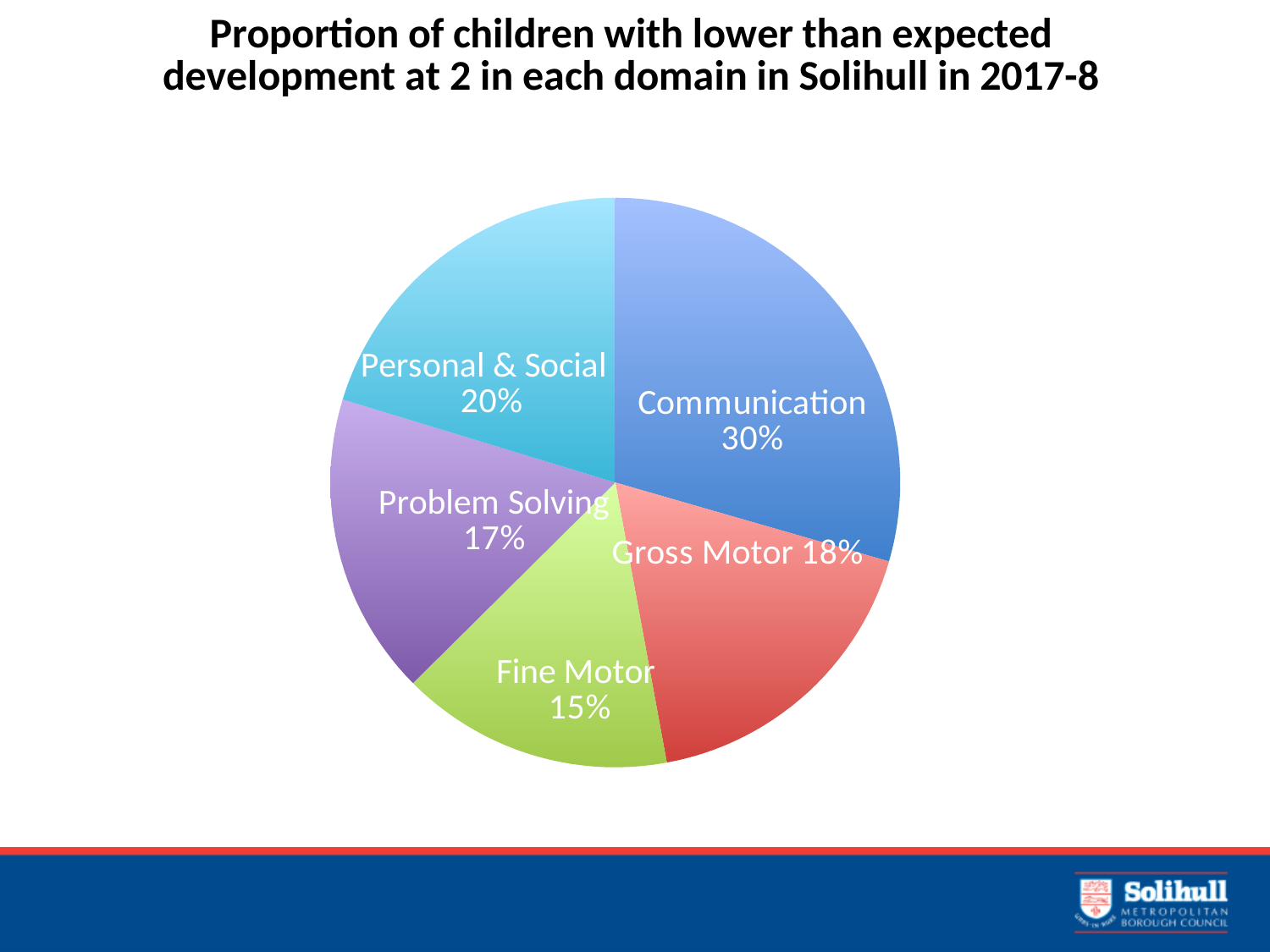
What is the title of the chart? Proportion of children with lower than expected development at 2 in each domain in Solihull in 2017-8 What kind of chart is shown on the slide? pie chart What percentage is shown for Communication? 30% What percentage is shown for Fine Motor? 15% How many slices does the pie chart have? 5 Which domain has the largest slice of the pie? Communication What percentage is shown for Problem Solving? 17% Which domain has the smallest slice of the pie? Fine Motor What is the difference in percentage points between Communication and Personal & Social? 10 What colour is the Fine Motor slice? green Which is larger, the slice for Personal & Social or the slice for Gross Motor? Personal & Social What percentage is shown for Gross Motor? 18%